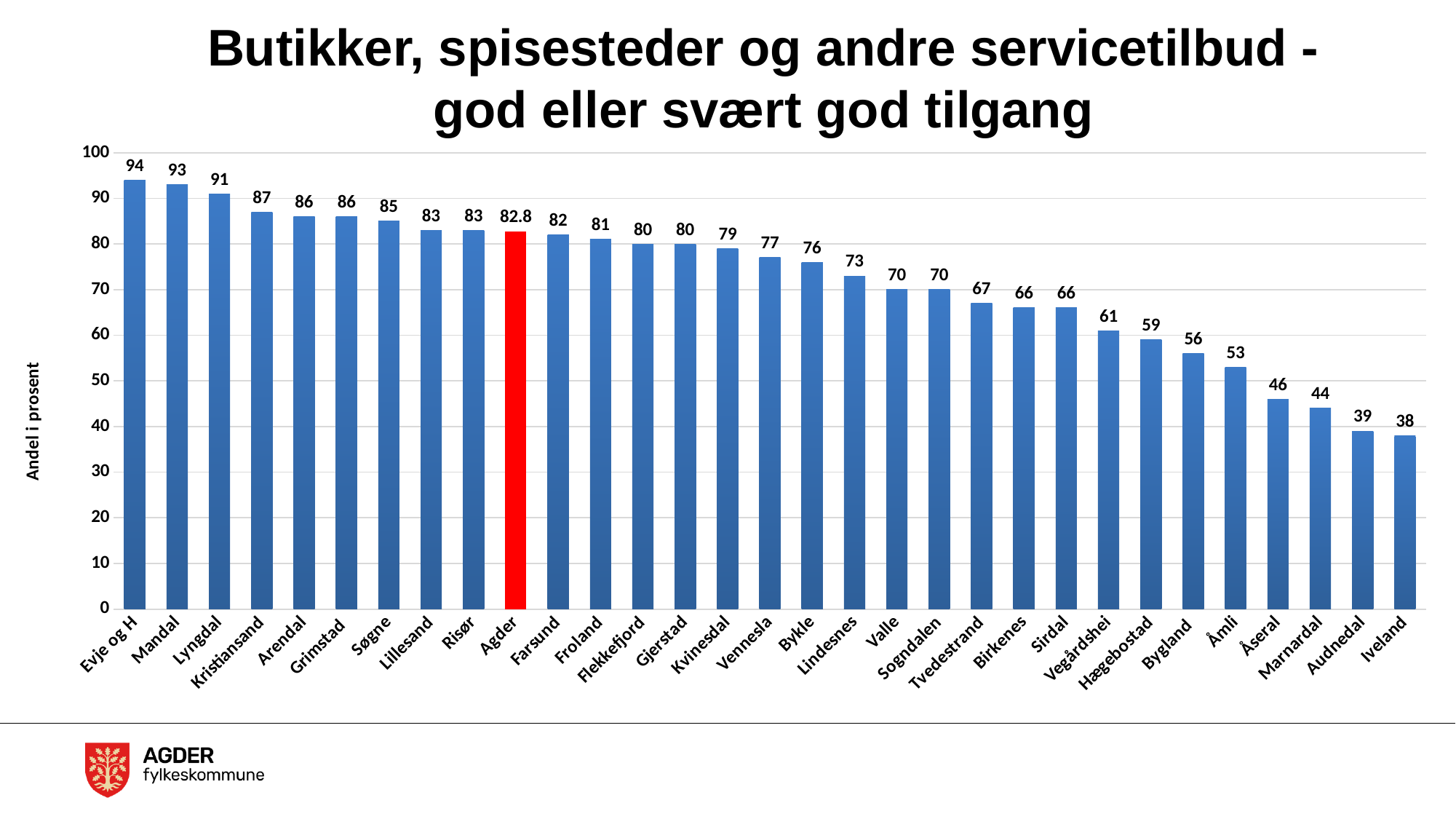
What is the difference between the values for Mandal and Bygland? 37 What kind of chart is this? bar chart Do the values rise or fall from left to right along the x axis? fall What is the value for Vegårdshei? 61 Which category has the highest value? Evje og H Is the value for Åseral greater or less than 50? less What is the value for Agder, the red bar? 82.8 What is the label on the vertical axis? Andel i prosent Which has a larger value, Farsund or Lindesnes? Farsund What is the value for Kristiansand? 87 Which category has the lowest value? Iveland How many categories are shown on the x axis? 31